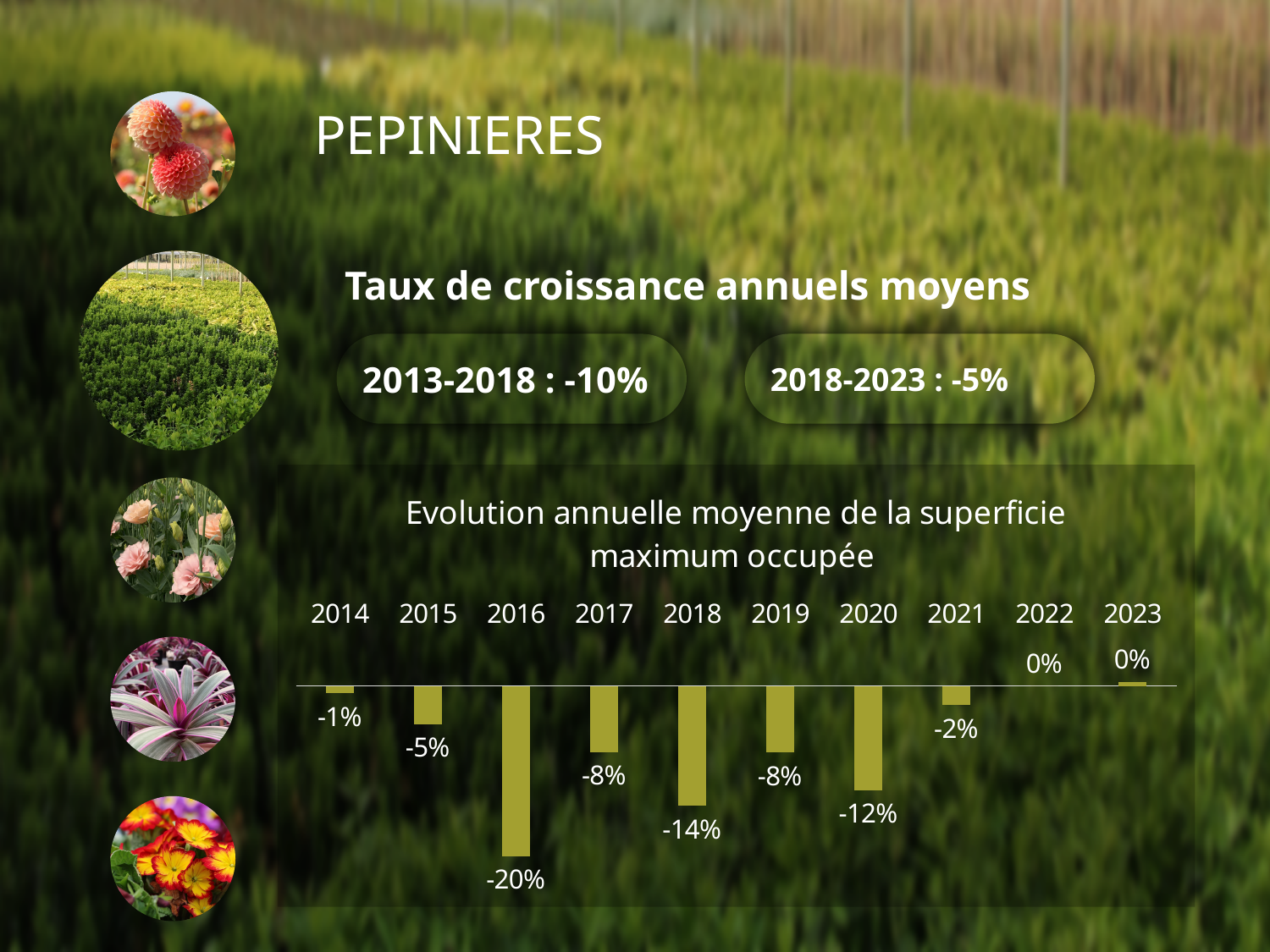
Do the values in the chart rise or fall from 2020 to 2023? Rise How many years are shown on the x axis of the chart? 10 What kind of chart is shown on the slide? Bar chart Which is larger, the value for 2017 or the value for 2018? 2017 What is the value for 2021 in the chart? -2% What is the difference between the values for 2020 and 2015? 7 percentage points Which years in the chart have a value of 0%? 2022 and 2023 What is the value for 2016 in the chart? -20% What is the value for 2014 in the chart? -1% What is the value for 2018 in the chart? -14% Which year has the lowest value in the chart? 2016 What is the title of the chart? Evolution annuelle moyenne de la superficie maximum occupée